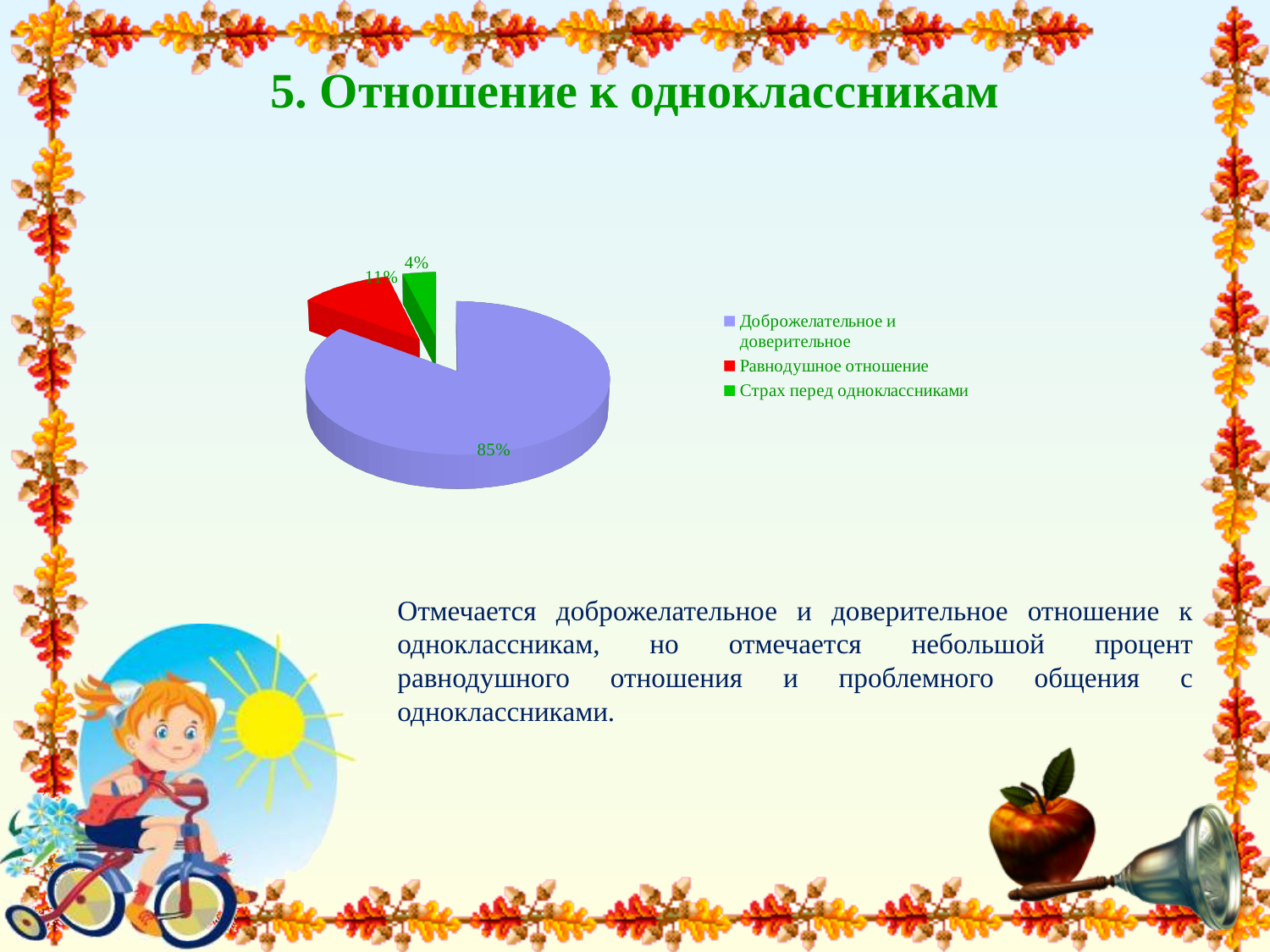
How many entries does the legend list? 3 How many slices does the pie chart have? 3 What share of the pie is labelled for "Доброжелательное и доверительное"? 85% What is the difference in percentage points between "Равнодушное отношение" and "Страх перед одноклассниками"? 7 What share of the pie is labelled for "Страх перед одноклассниками"? 4% Which category has the smallest slice of the pie? Страх перед одноклассниками Which is larger: the slice for "Равнодушное отношение" or the slice for "Страх перед одноклассниками"? Равнодушное отношение What is the difference in percentage points between "Доброжелательное и доверительное" and "Равнодушное отношение"? 74 What colour is the slice for "Равнодушное отношение"? Red What share of the pie is labelled for "Равнодушное отношение"? 11% What kind of chart is shown on the slide? Pie chart Which category has the largest slice of the pie? Доброжелательное и доверительное